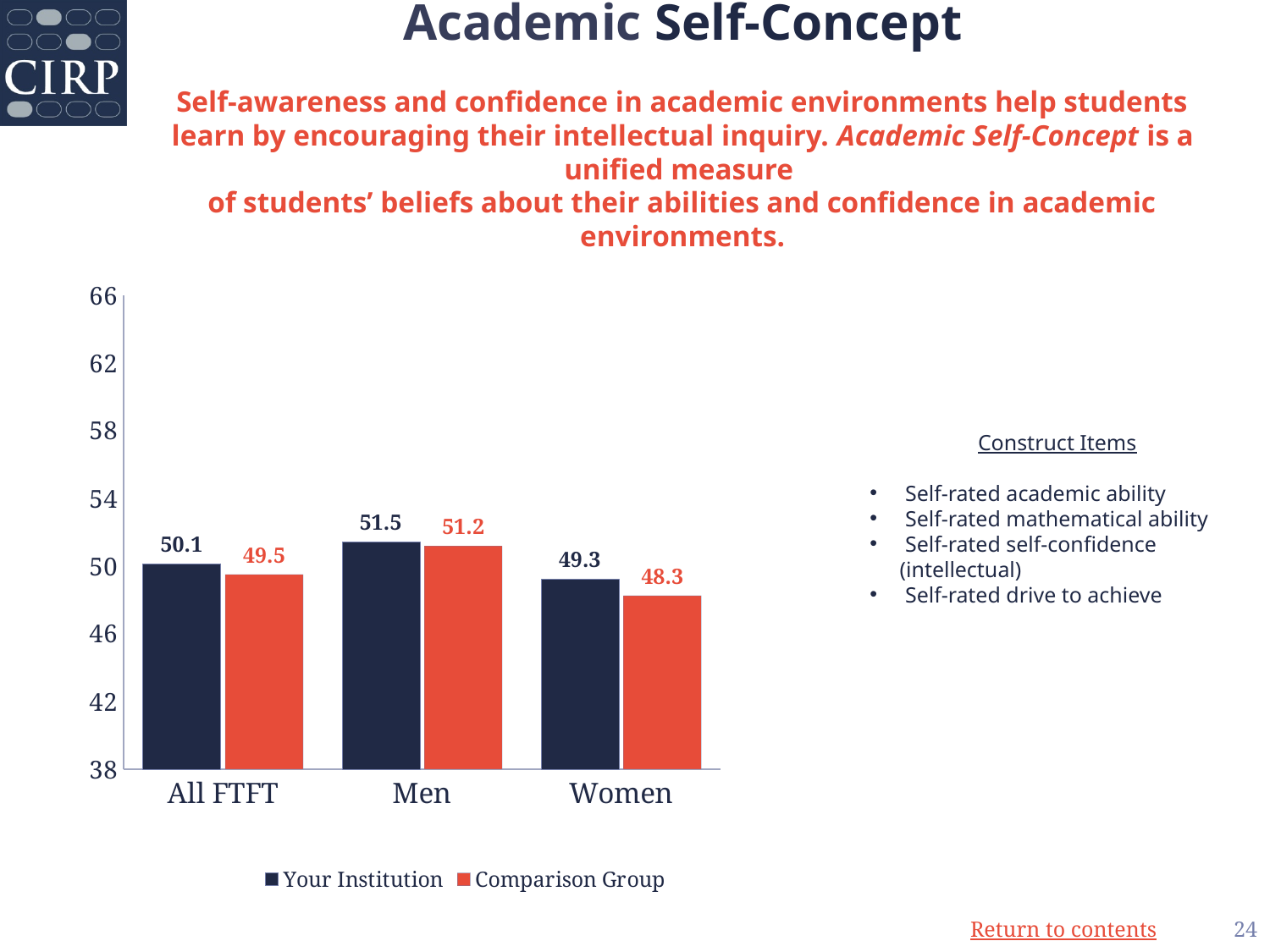
What is the difference between the Your Institution and Comparison Group values for Women? 1.0 How many series does the legend list? 2 What is the Your Institution value for Men? 51.5 Which category has the lowest Your Institution value? Women What is the Comparison Group value for Women? 48.3 Which category has the highest Comparison Group value? Men What kind of chart is shown on the slide? bar chart How many categories are shown on the x axis? 3 Which is larger for All FTFT: Your Institution or Comparison Group? Your Institution Is the Comparison Group value for Men greater or less than 50? greater What colour are the Comparison Group bars? red/orange What is the Your Institution value for All FTFT? 50.1